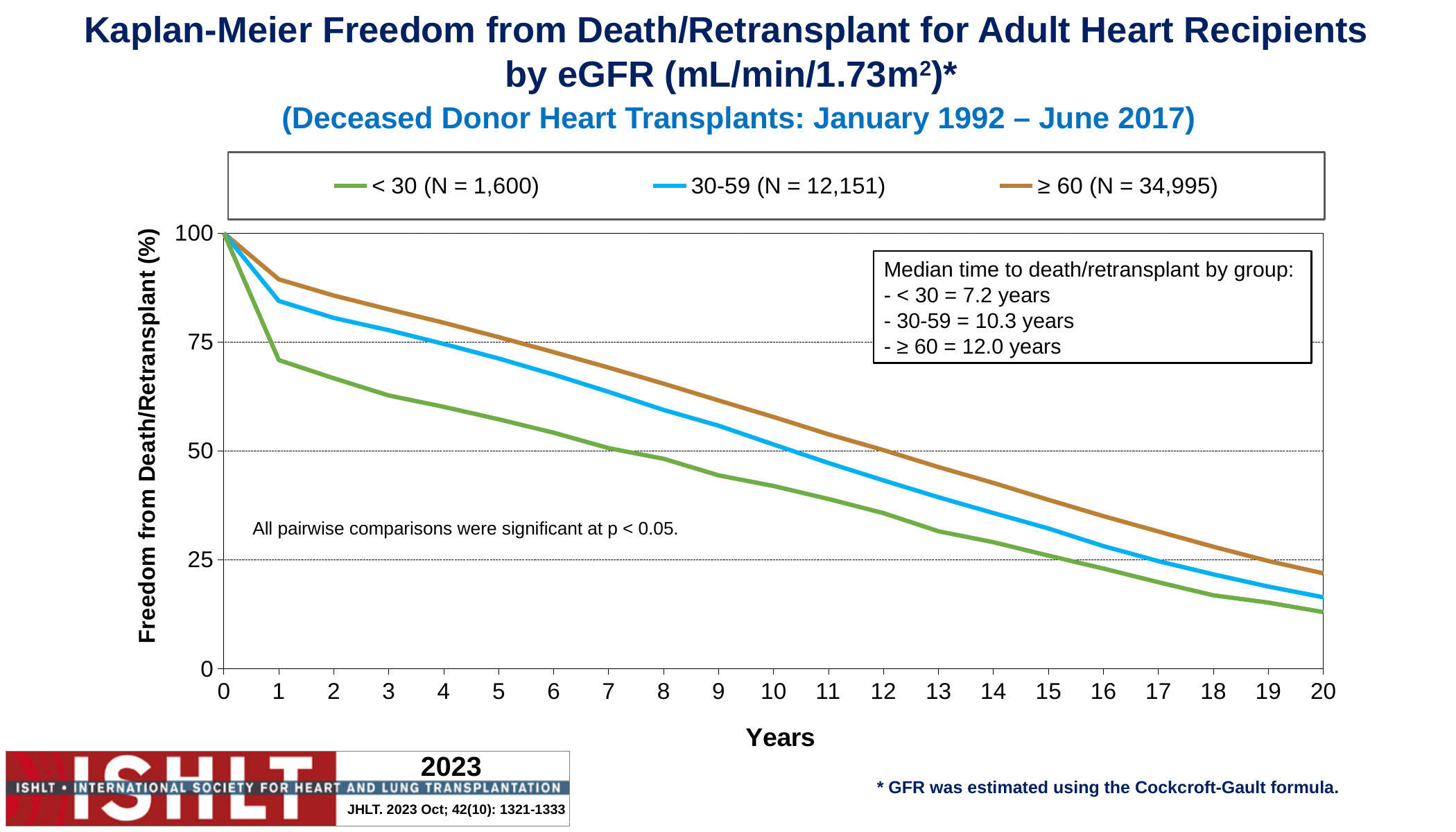
How many series does the legend list? 3 At year 15, which group has the higher freedom from death/retransplant, 30-59 or < 30? 30-59 Is the value for the < 30 group at year 20 greater or less than 25? less Is the value for the ≥ 60 group at year 10 greater or less than 50? greater What is the median time to death/retransplant for the 30-59 group, as stated on the slide? 10.3 years Do the curves rise or fall as years increase? fall What is the freedom from death/retransplant for all groups at year 0? 100 What kind of chart is shown on the slide? line chart Which eGFR group has the highest freedom from death/retransplant at 20 years? ≥ 60 Which eGFR group has the lowest freedom from death/retransplant at 10 years? < 30 Is the value for the < 30 group at year 1 greater or less than 50? greater What is the N for the ≥ 60 group shown in the legend? 34,995